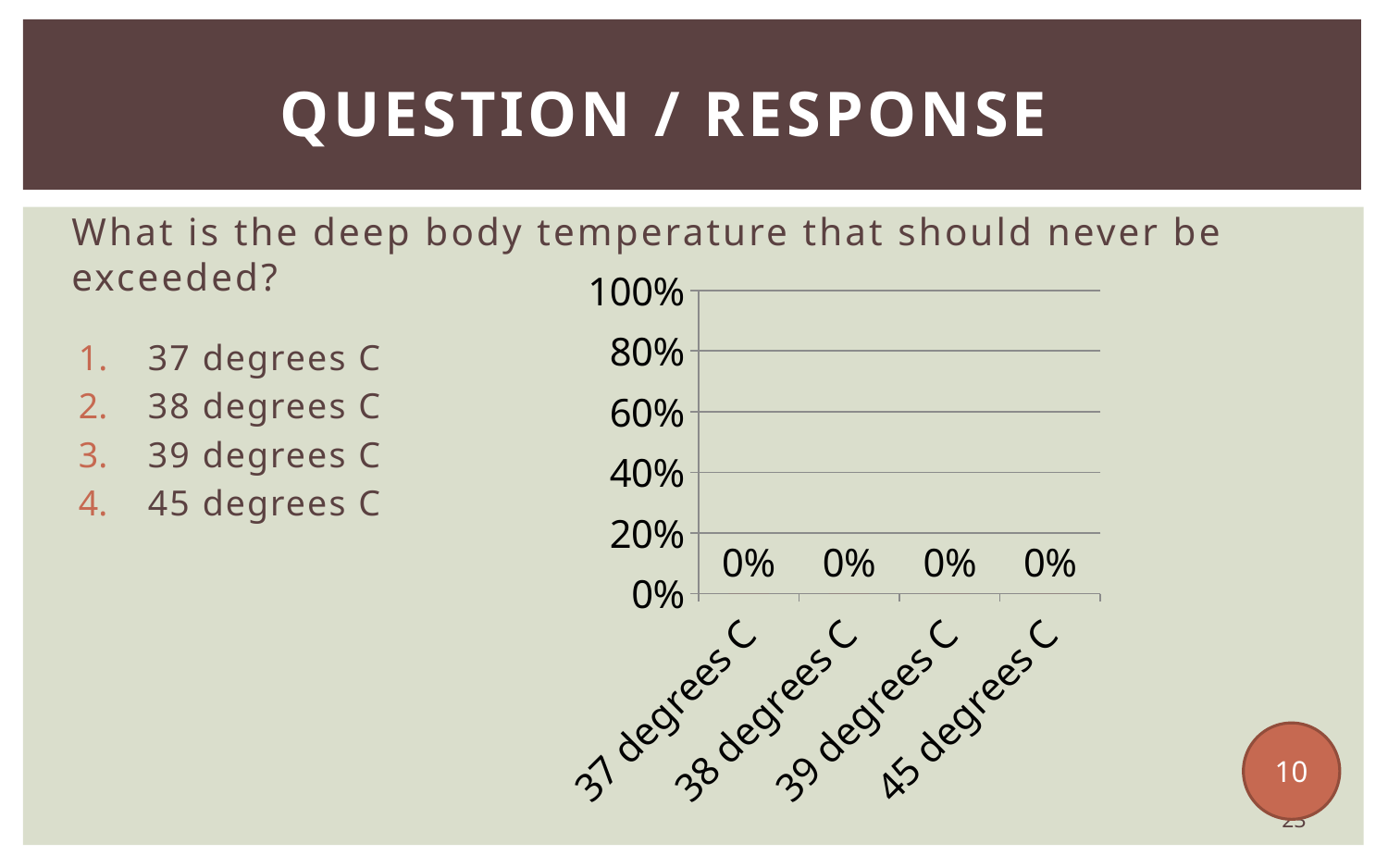
What value is shown for 45 degrees C? 0% How many categories are shown on the x axis of the chart? 4 Is the value for 39 degrees C greater or less than 40%? less What is the highest value labelled on the y axis of the chart? 100% What kind of chart is shown on the slide? bar chart What value is shown for 37 degrees C? 0% Is the value for 38 degrees C greater or less than 20%? less What value is shown for 38 degrees C? 0% What is the difference between the values for 37 degrees C and 45 degrees C? 0% What value is shown for 39 degrees C? 0% What is the label of the last category on the x axis? 45 degrees C